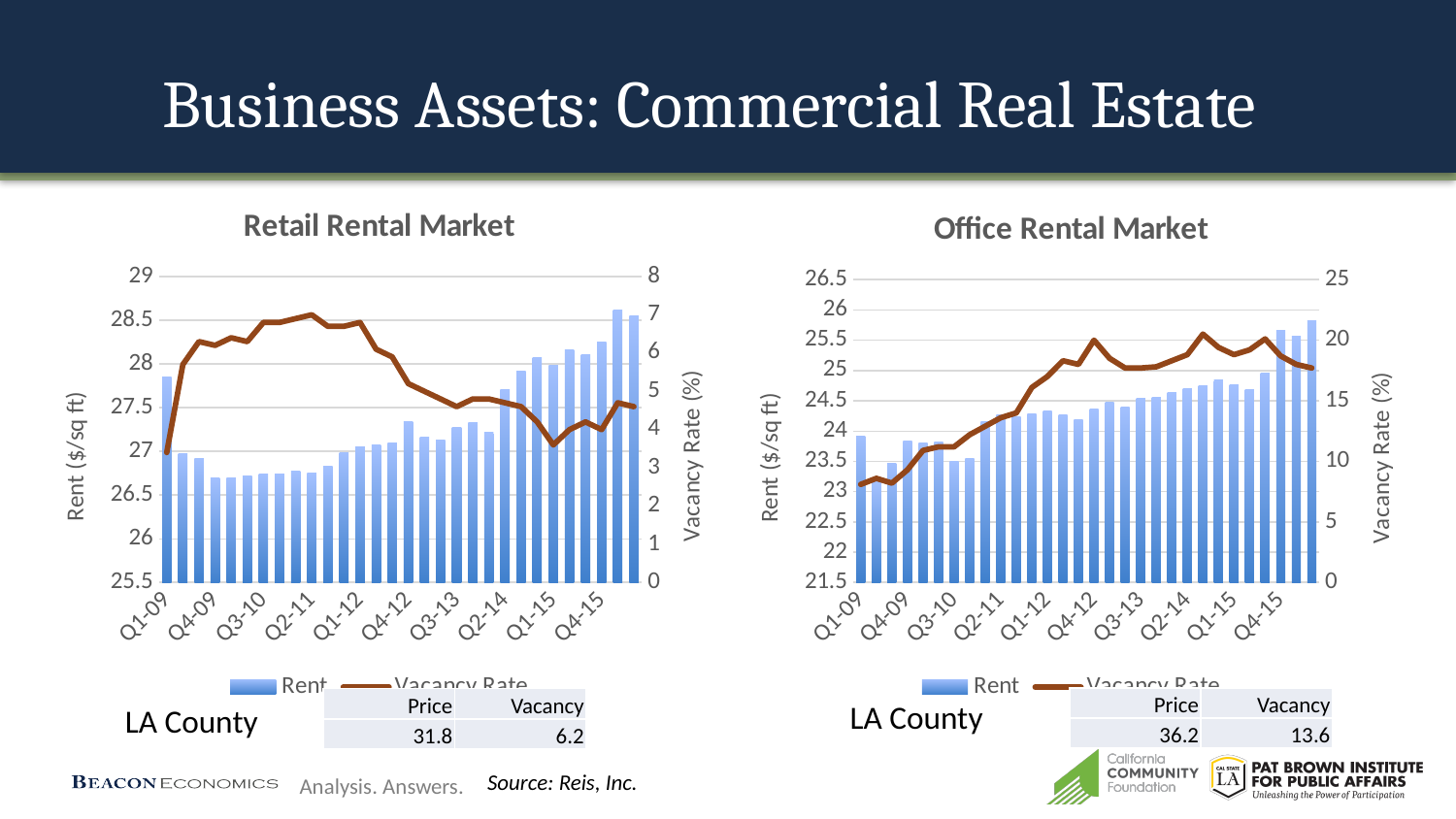
In the Office Rental Market chart, is the Vacancy Rate for Q1-09 greater or less than 10? Less What is the title of the right-hand vertical axis on the Retail Rental Market chart? Vacancy Rate (%) In the Office Rental Market chart, which labelled quarter has the highest Rent? Q4-15 In the Office Rental Market chart, is the Vacancy Rate for Q4-15 greater or less than 15? Greater In the Retail Rental Market chart, is the Rent value for Q1-09 greater or less than 27.5? Greater In the Retail Rental Market chart, which has the higher Rent, Q1-09 or Q4-09? Q1-09 How many series does the legend of the Office Rental Market chart list? 2 What kind of chart is the Retail Rental Market chart? A combined bar and line chart In the Office Rental Market chart, do the Rent bars generally rise or fall from Q1-09 to Q4-15? Rise